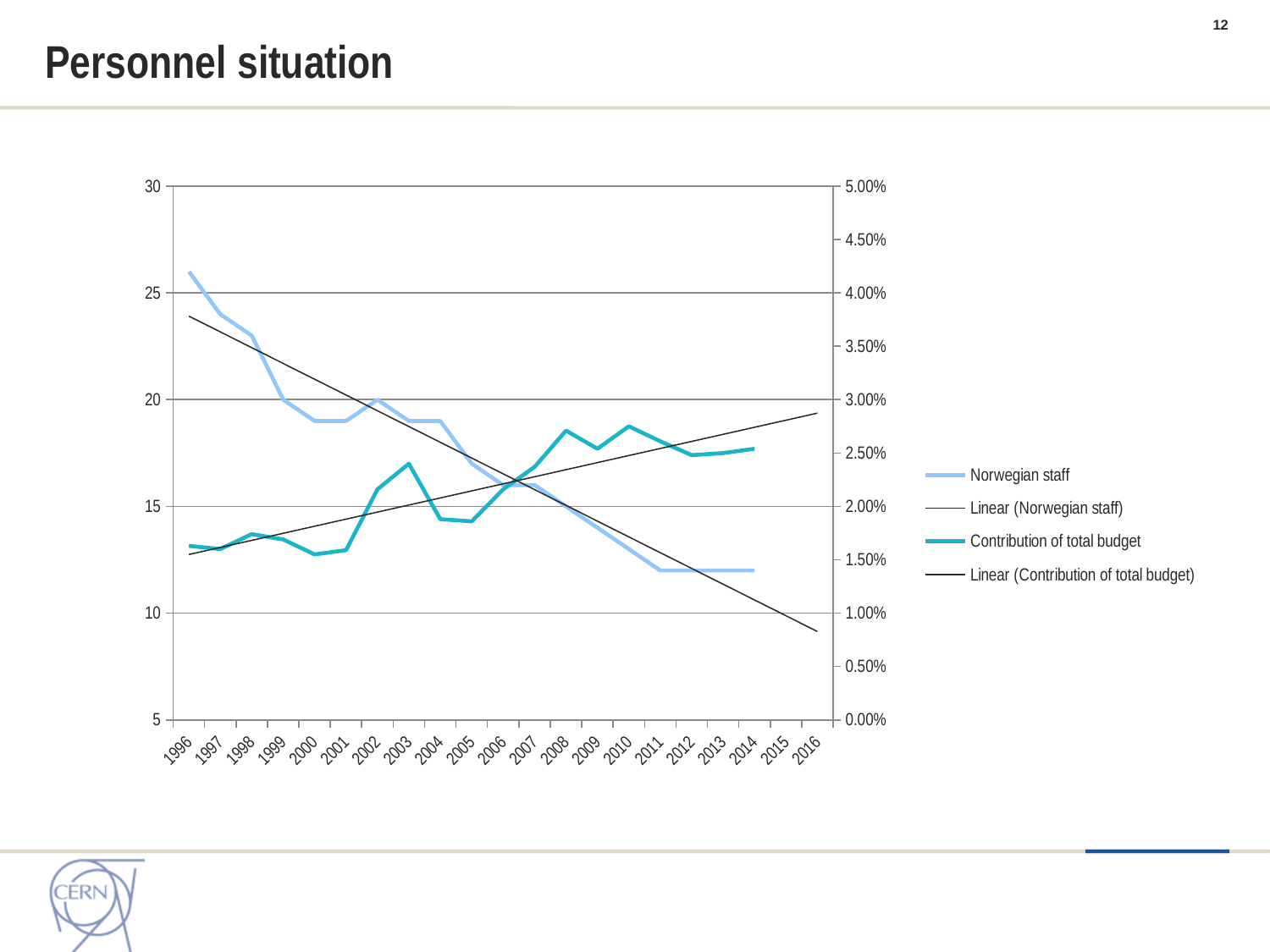
How many year labels are shown on the x axis? 21 In which year is the Norwegian staff series at its highest? 1996 What is the highest value shown on the right-hand axis? 5.00% What kind of chart is shown on the slide? line chart Is the value for Norwegian staff in 2014 greater or less than 15? less How many series does the legend list? 4 Is the value for Contribution of total budget in 2010 greater or less than 2.50%? greater Which year has the larger Norwegian staff value, 1996 or 2014? 1996 Does the Contribution of total budget series rise or fall overall from 1996 to 2014? rise Does the Norwegian staff series rise or fall from 1996 to 2014? fall Is the value for Norwegian staff in 1996 greater or less than 25? greater